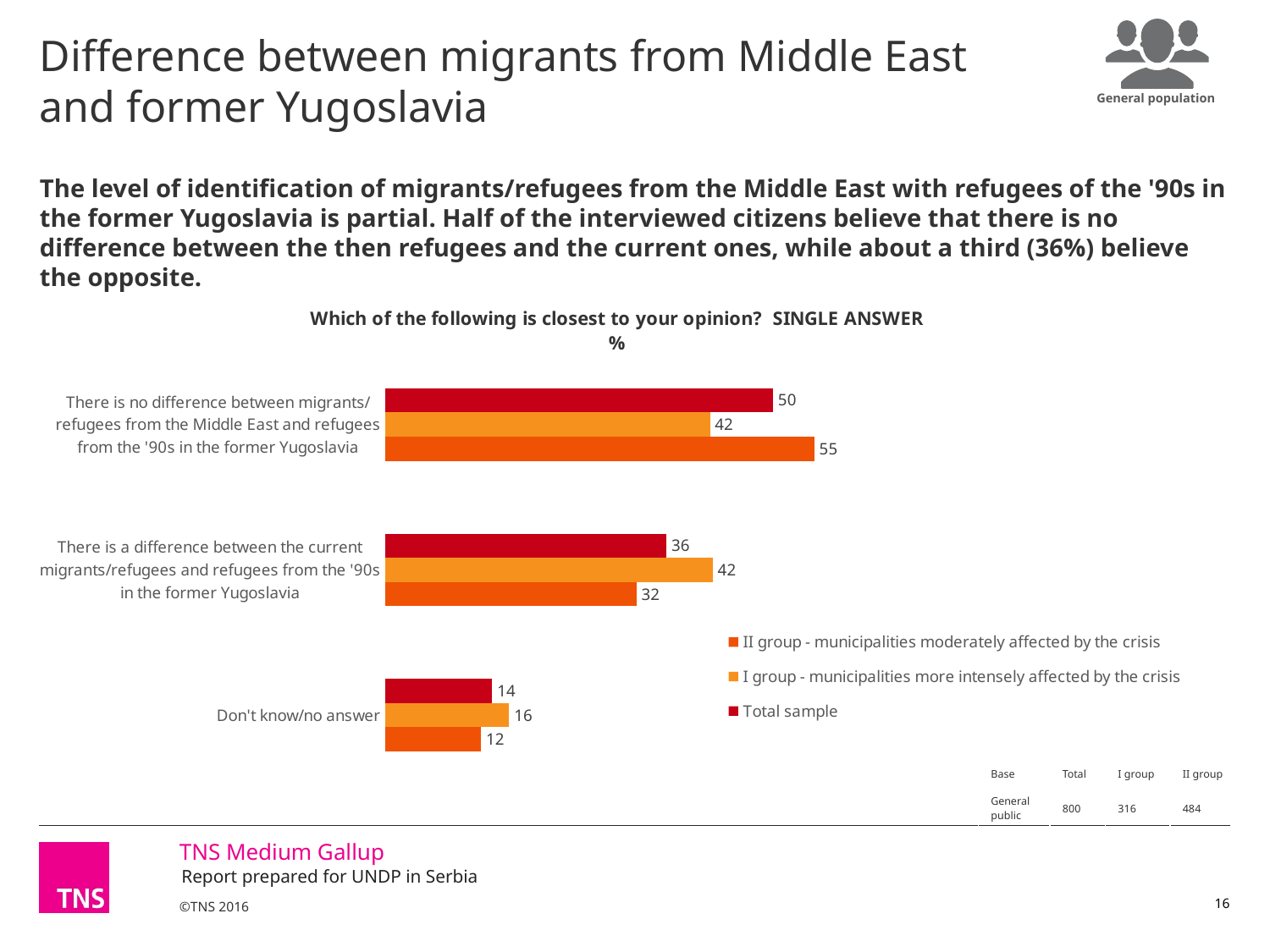
How many response categories are shown in the chart? 3 Which category has the highest Total sample value? There is no difference between migrants/refugees from the Middle East and refugees from the '90s in the former Yugoslavia What is the value for 'II group - municipalities moderately affected by the crisis' for 'There is a difference between the current migrants/refugees and refugees from the '90s in the former Yugoslavia'? 32 For 'There is a difference between the current migrants/refugees and refugees from the '90s in the former Yugoslavia', which is larger: the I group value or the Total sample value? I group What is the Total sample value for 'There is no difference between migrants/refugees from the Middle East and refugees from the '90s in the former Yugoslavia'? 50 Which category has the lowest value for the II group series? Don't know/no answer What is the value for 'I group - municipalities more intensely affected by the crisis' for 'Don't know/no answer'? 16 What is the difference between the Total sample values for 'There is no difference...' and 'There is a difference...'? 14 What is the difference between the II group and I group values for 'There is no difference between migrants/refugees from the Middle East and refugees from the '90s in the former Yugoslavia'? 13 What type of chart is shown on the slide? Bar chart What is the title of the chart? Which of the following is closest to your opinion? SINGLE ANSWER How many series does the chart legend list? 3